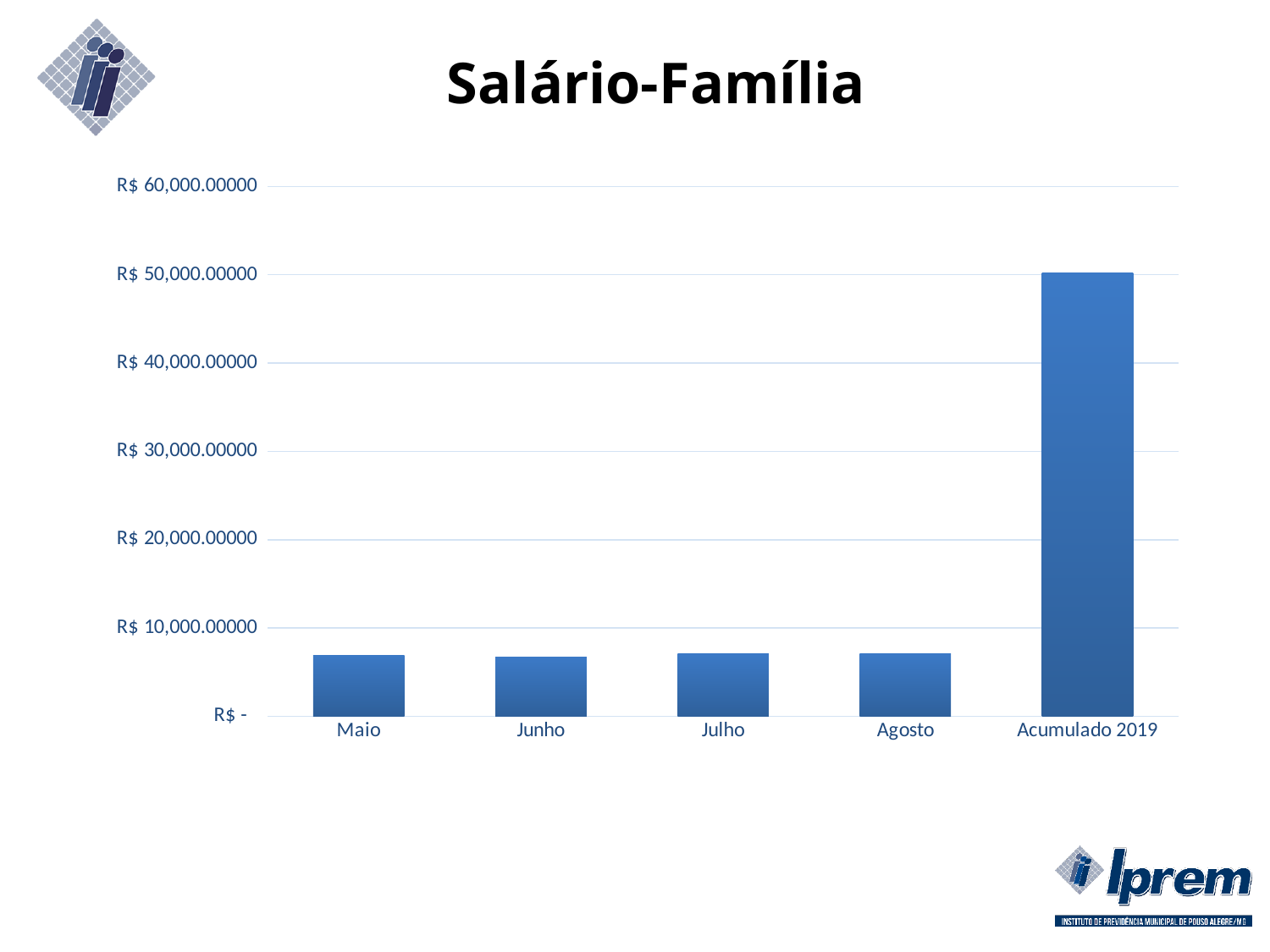
Is the value for Julho greater or less than R$ 20,000.00000? less What kind of chart is shown on the slide? bar chart Which category has the highest value in the chart? Acumulado 2019 What is the highest value shown on the y axis of the chart? R$ 60,000.00000 Is the value for Acumulado 2019 greater or less than R$ 40,000.00000? greater Is the value for Agosto greater or less than R$ 10,000.00000? less How many categories are shown on the x axis of the chart? 5 Which is larger, the value for Acumulado 2019 or the value for Junho? Acumulado 2019 What is the title of the chart? Salário-Família